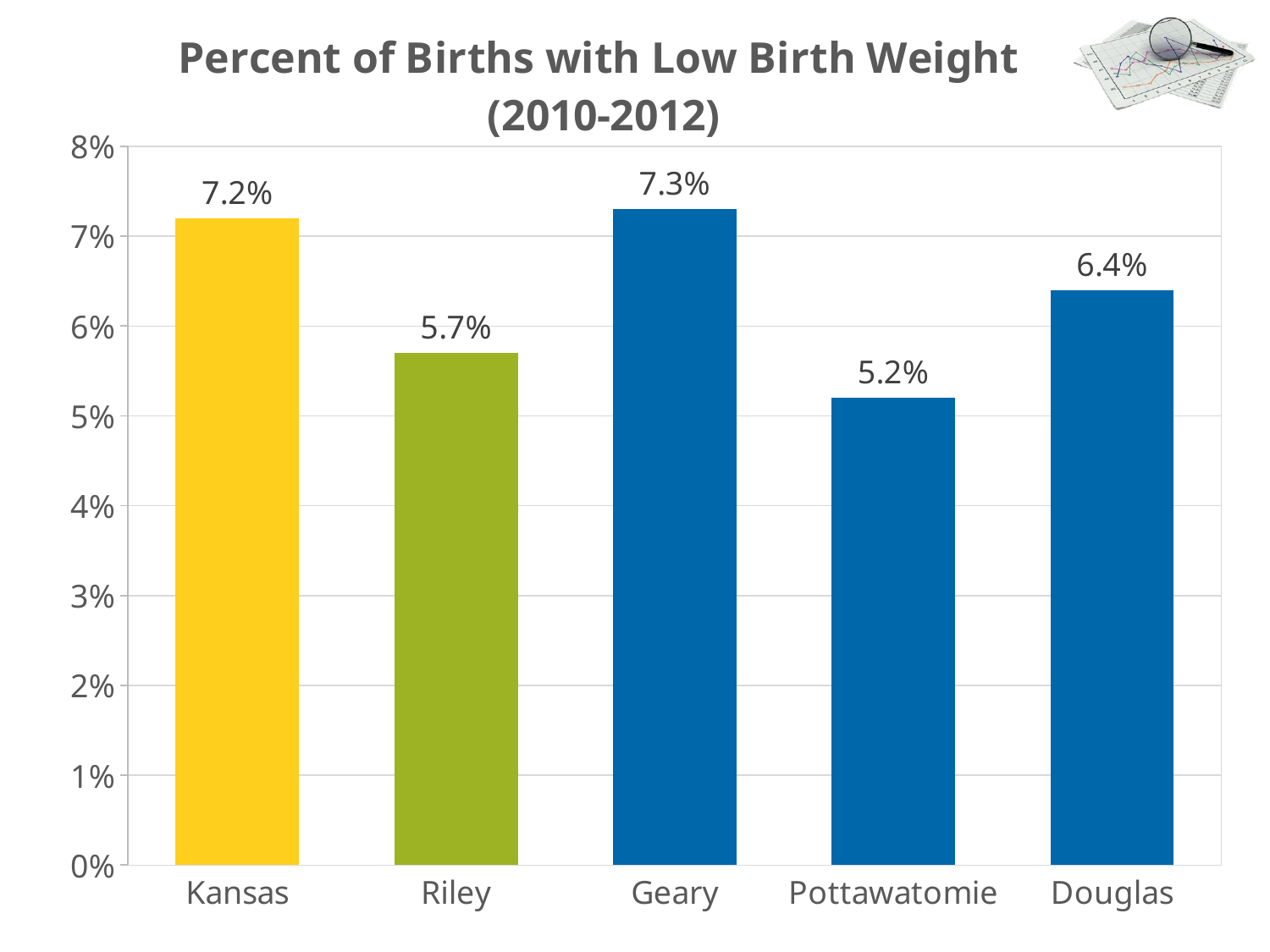
Is the value for Riley greater or less than 6%? less Which category has the highest percent of births with low birth weight? Geary What is the percent of births with low birth weight for Kansas? 7.2% What is the difference between the values for Kansas and Douglas? 0.8% What is the percent of births with low birth weight for Pottawatomie? 5.2% Which has a higher percent of births with low birth weight, Riley or Douglas? Douglas What is the percent of births with low birth weight for Douglas? 6.4% How many categories are shown on the x axis? 5 What is the percent of births with low birth weight for Riley? 5.7% Which category has the lowest percent of births with low birth weight? Pottawatomie What is the difference between the values for Geary and Pottawatomie? 2.1% What kind of chart is shown on the slide? Bar chart